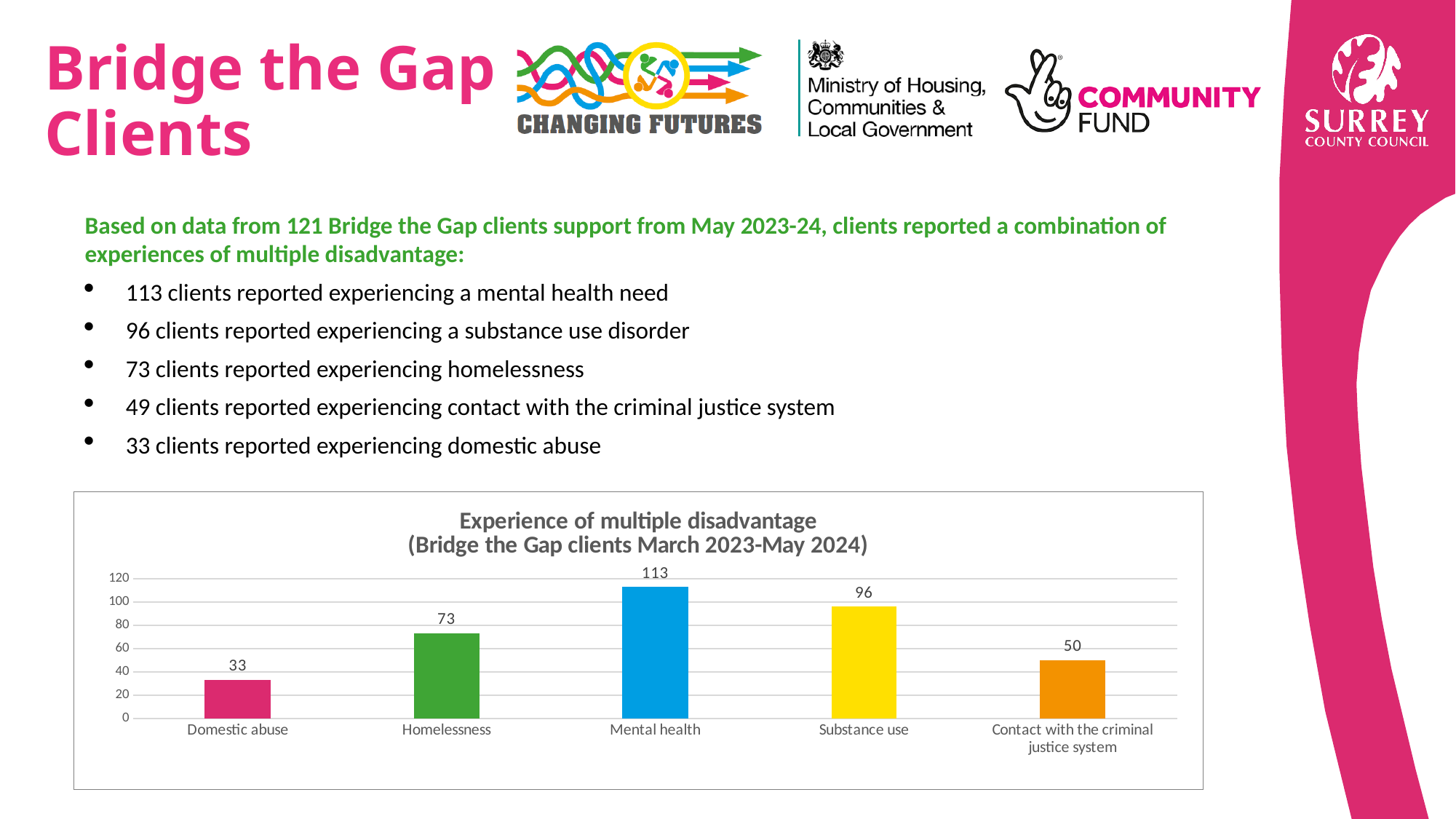
What is the value for Domestic abuse in the chart? 33 What kind of chart is shown on the slide? Bar chart Which is larger, the value for Homelessness or the value for Contact with the criminal justice system? Homelessness What is the value for Mental health in the chart? 113 What is the difference between the values for Mental health and Substance use? 17 What is the title of the chart? Experience of multiple disadvantage (Bridge the Gap clients March 2023-May 2024) What is the value for Contact with the criminal justice system in the chart? 50 Which category has the highest value in the chart? Mental health What is the difference between the values for Homelessness and Domestic abuse? 40 How many categories are shown in the chart? 5 Which category has the lowest value in the chart? Domestic abuse Is the value for Substance use greater or less than 80? greater